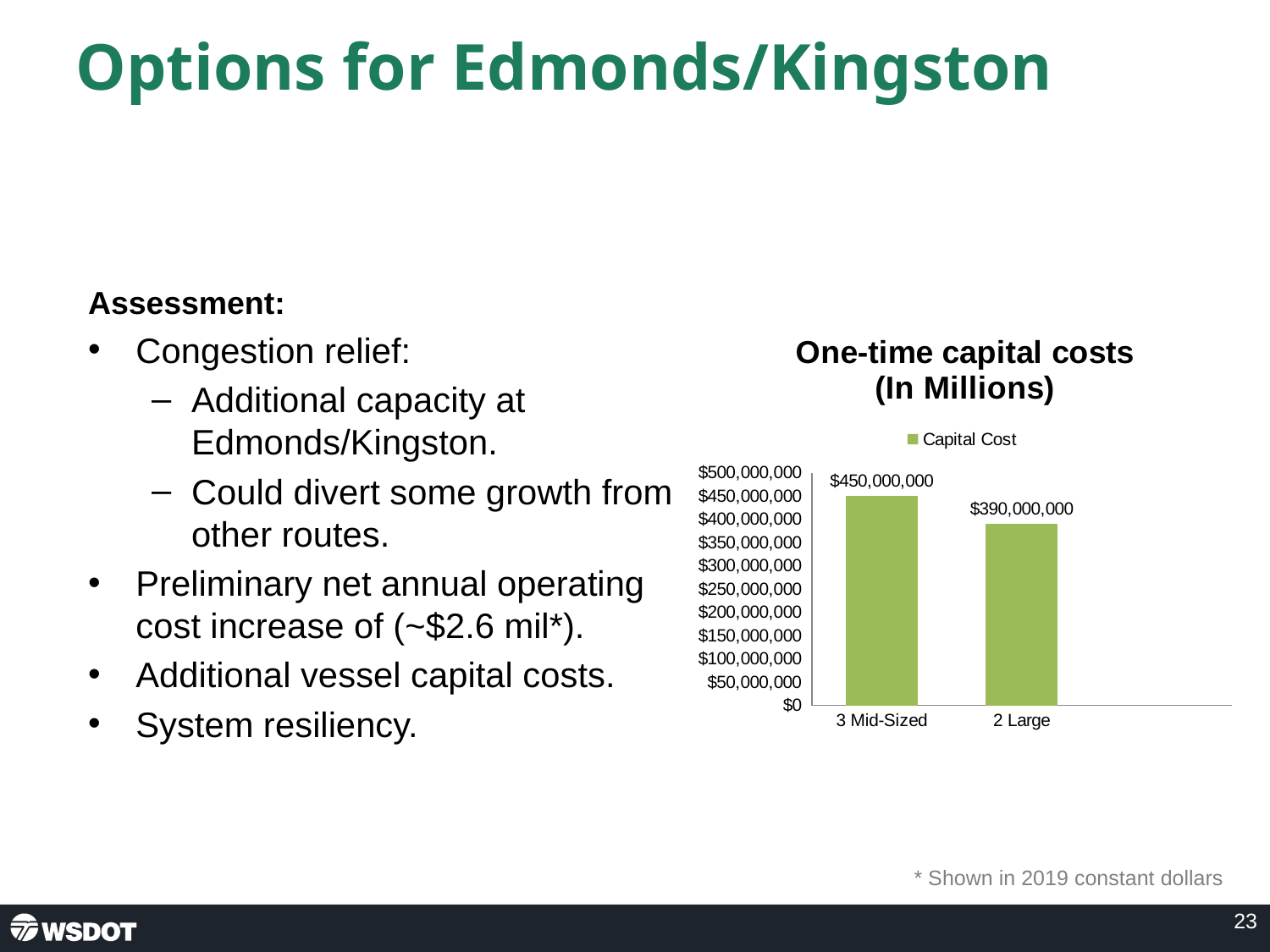
What kind of chart is shown on the slide? Bar chart What is the capital cost for 3 Mid-Sized? $450,000,000 How many options are shown in the chart? 2 What is the difference in capital cost between 3 Mid-Sized and 2 Large? $60,000,000 Which option has the higher one-time capital cost? 3 Mid-Sized Is the capital cost for 2 Large greater or less than $400,000,000? less Is the capital cost for 3 Mid-Sized greater or less than $400,000,000? greater What is the capital cost for 2 Large? $390,000,000 What is the legend entry for the chart? Capital Cost What is the title of the chart? One-time capital costs (In Millions) Which option has the lower one-time capital cost? 2 Large How many series does the legend list? 1